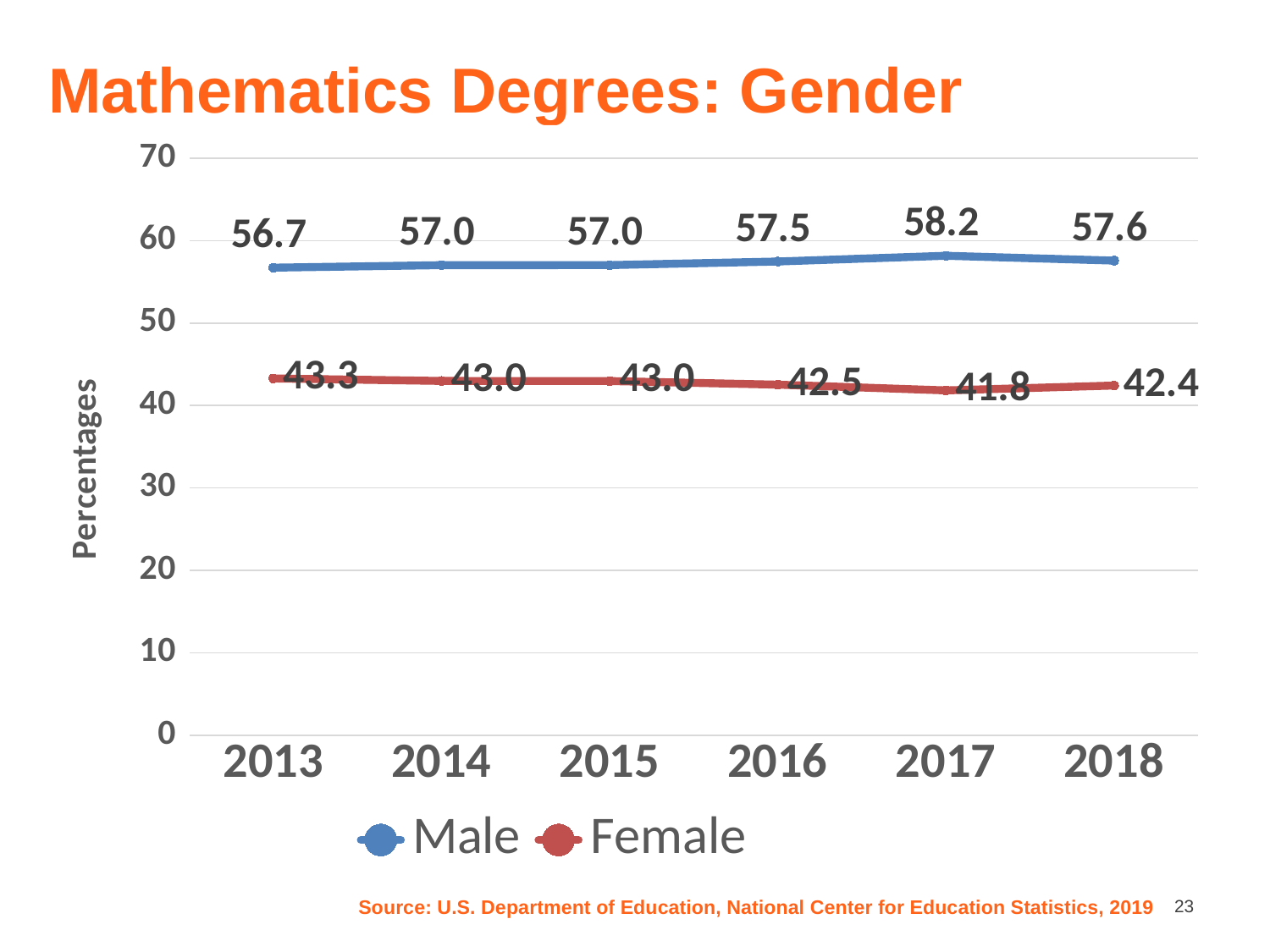
How many years are shown on the x axis? 6 Is the Female value for 2015 greater or less than 50? less What is the Male value for 2017? 58.2 What is the Female value for 2018? 42.4 Which is larger in 2016, the Male value or the Female value? Male How many series does the legend list? 2 What kind of chart is shown on the slide? line chart What is the Female value for 2013? 43.3 In which year is the Female series lowest? 2017 What is the title of the chart? Mathematics Degrees: Gender What is the difference between the Male and Female values in 2013? 13.4 In which year is the Male series highest? 2017